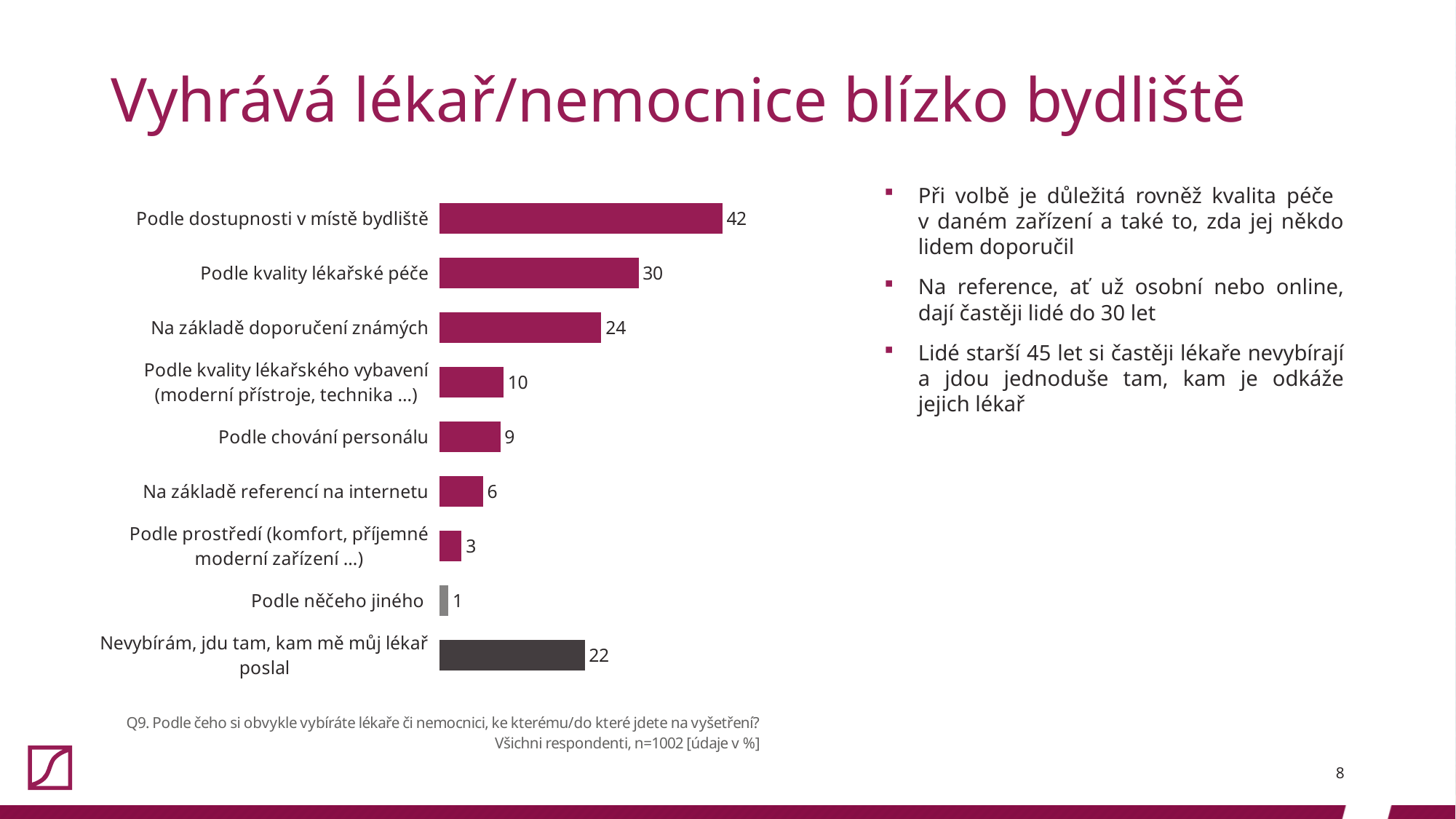
What is the value for "Podle dostupnosti v místě bydliště"? 42 How many categories are shown in the chart? 9 Which bar in the chart is coloured dark grey rather than magenta? Nevybírám, jdu tam, kam mě můj lékař poslal What is the value for "Nevybírám, jdu tam, kam mě můj lékař poslal"? 22 Which is larger: the value for "Na základě doporučení známých" or the value for "Nevybírám, jdu tam, kam mě můj lékař poslal"? Na základě doporučení známých What is the difference between the values for "Podle dostupnosti v místě bydliště" and "Podle kvality lékařské péče"? 12 What kind of chart is shown on the slide? Bar chart What is the value for "Podle kvality lékařské péče"? 30 What is the value for "Na základě referencí na internetu"? 6 Which category has the lowest value? Podle něčeho jiného Which category has the highest value? Podle dostupnosti v místě bydliště What is the difference between the values for "Podle kvality lékařského vybavení (moderní přístroje, technika …)" and "Podle chování personálu"? 1